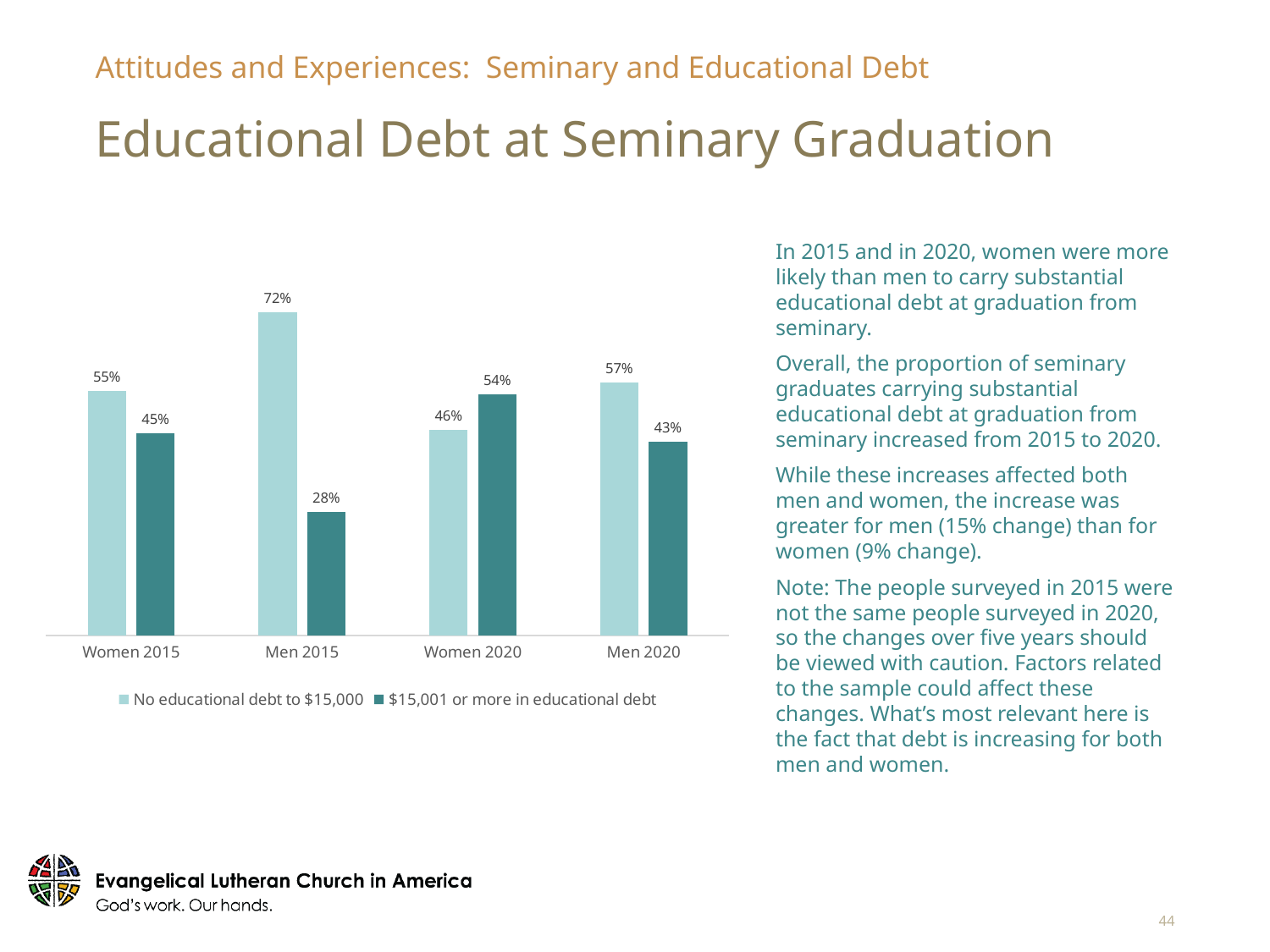
How many series does the legend list? 2 Which is larger: the $15,001 or more in educational debt value for Women 2020 or for Men 2020? Women 2020 What percentage of Men 2020 had no educational debt to $15,000? 57% What kind of chart is shown on the slide? Bar chart What percentage of Women 2020 had $15,001 or more in educational debt? 54% What is the difference between the $15,001 or more in educational debt values for Men 2020 and Men 2015? 15% How many categories are shown on the x axis? 4 What percentage of Men 2015 had $15,001 or more in educational debt? 28% What is the difference between the $15,001 or more in educational debt values for Women 2020 and Women 2015? 9% Which category has the highest value for no educational debt to $15,000? Men 2015 What percentage of Women 2015 had no educational debt to $15,000? 55% Which category has the lowest value for $15,001 or more in educational debt? Men 2015